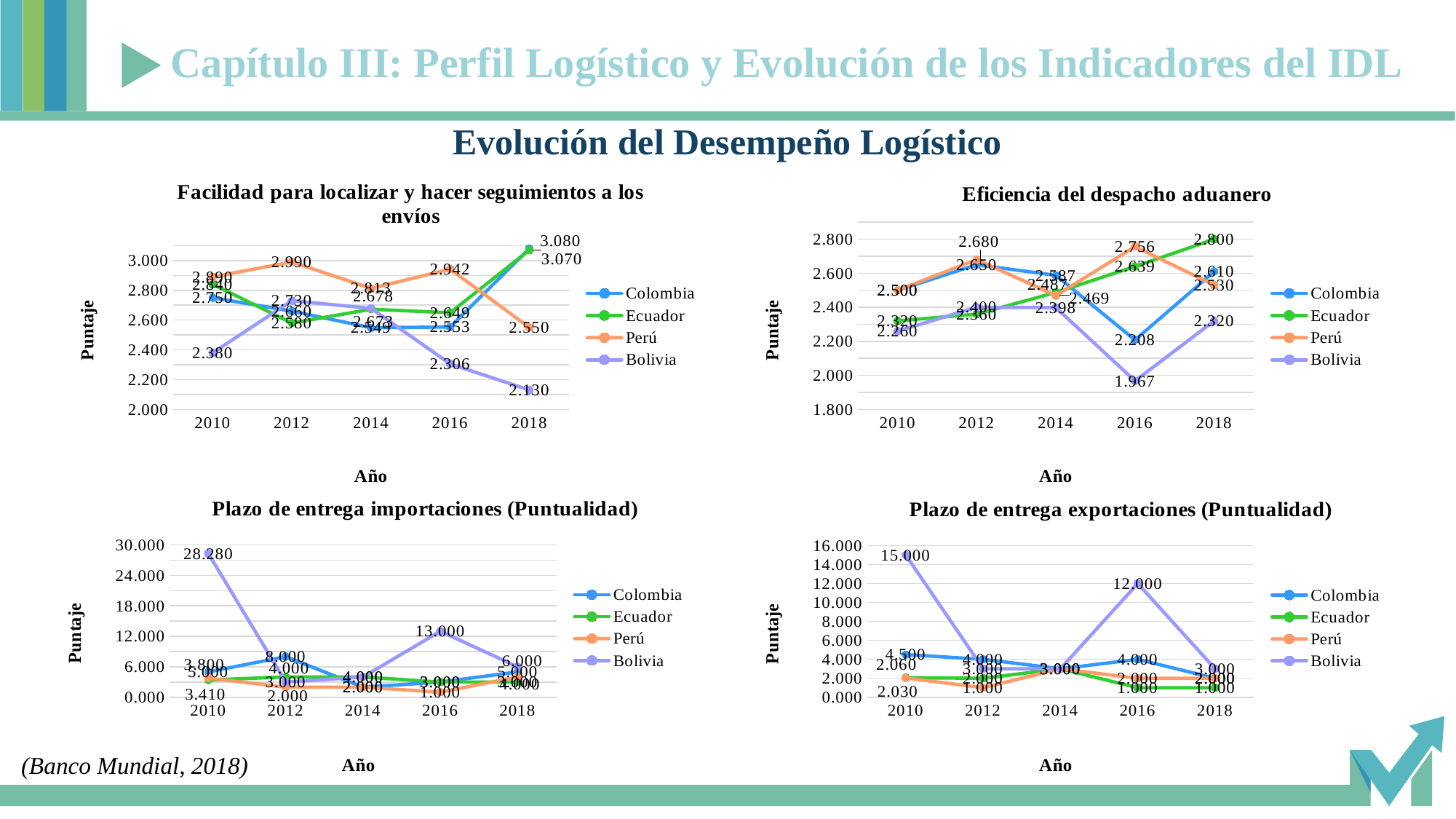
How many series does the legend of the chart 'Plazo de entrega exportaciones (Puntualidad)' list? 4 In the chart 'Plazo de entrega importaciones (Puntualidad)', what is the value for Bolivia in 2010? 28.280 In the chart 'Eficiencia del despacho aduanero', what is the value for Perú in 2016? 2.756 What kind of chart is 'Eficiencia del despacho aduanero'? line chart In the chart 'Eficiencia del despacho aduanero', which series has the highest value in 2018? Ecuador In the chart 'Facilidad para localizar y hacer seguimientos a los envíos', what is the value for Bolivia in 2018? 2.130 In the chart 'Eficiencia del despacho aduanero', what is the value for Bolivia in 2016? 1.967 In the chart 'Plazo de entrega importaciones (Puntualidad)', which series has the highest value in 2016? Bolivia In the chart 'Facilidad para localizar y hacer seguimientos a los envíos', which year has the lowest value for Bolivia? 2018 In the chart 'Facilidad para localizar y hacer seguimientos a los envíos', what is the value for Perú in 2012? 2.990 In the chart 'Plazo de entrega exportaciones (Puntualidad)', is the value for Bolivia in 2010 larger or smaller than the value for Bolivia in 2016? larger In the chart 'Eficiencia del despacho aduanero', what is the difference between Perú and Bolivia in 2016? 0.789